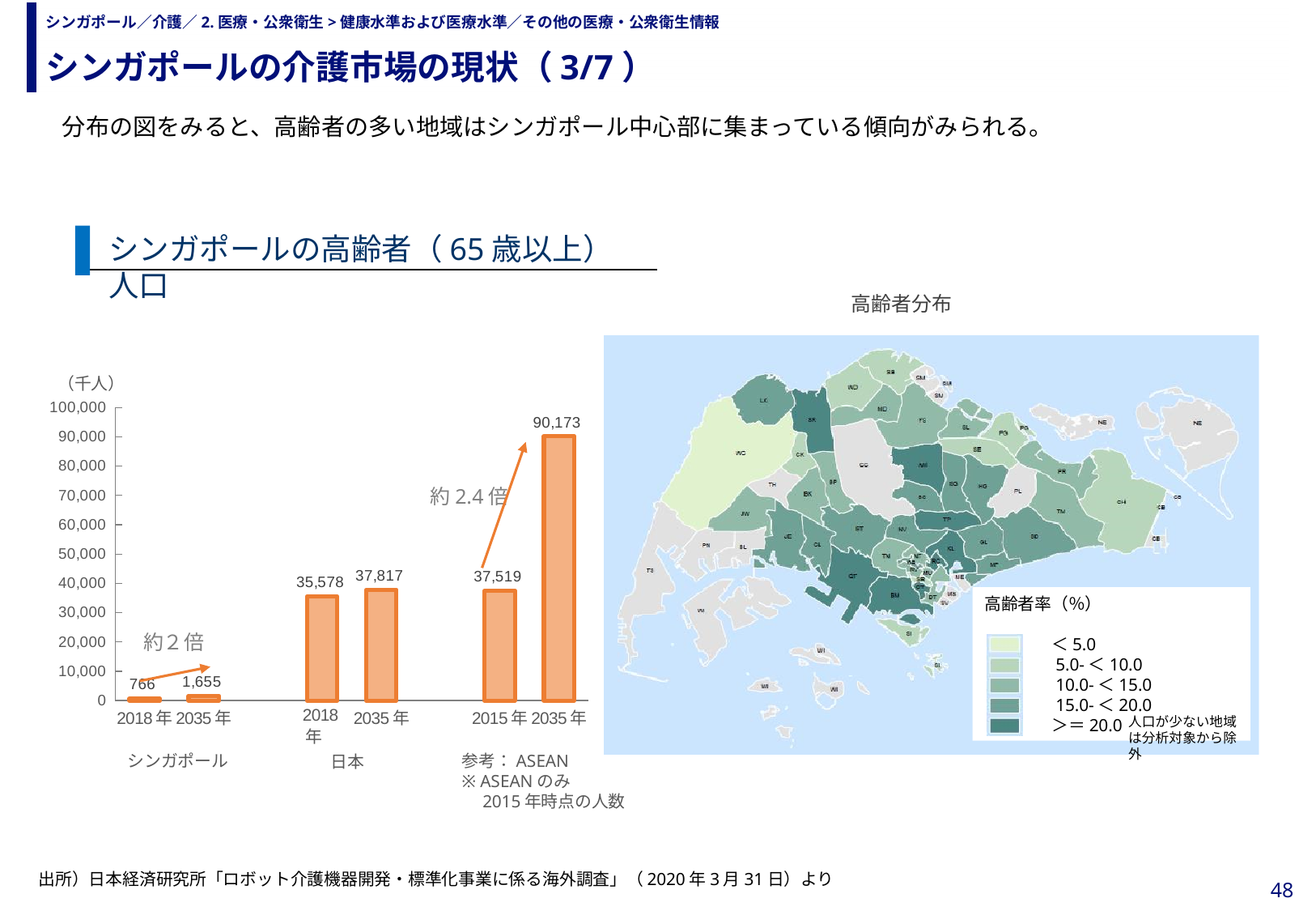
In the bar chart of elderly (65+) population, what is the value for Japan in 2035? 37,817 In the bar chart of elderly (65+) population, is the value for ASEAN in 2035 greater or less than 80,000? greater In the bar chart of elderly (65+) population, what is the difference between Japan's 2035 and 2018 values? 2,239 In the bar chart of elderly (65+) population, what is the value for ASEAN in 2015? 37,519 How many bars are plotted in the bar chart of elderly (65+) population? 6 What unit is shown on the vertical axis of the bar chart of elderly (65+) population? 千人 In the bar chart of elderly (65+) population, which is larger: Japan 2018 or ASEAN 2015? ASEAN 2015 (37,519) In the bar chart of elderly (65+) population, what is the value for Singapore in 2035? 1,655 In the bar chart of elderly (65+) population, which bar has the highest value? ASEAN 2035年 (90,173) In the bar chart of elderly (65+) population, which bar has the lowest value? シンガポール 2018年 (766) What type of chart is used to show the elderly (65+) population on the left of the slide? bar chart In the bar chart of elderly (65+) population, what is the value for Singapore in 2018? 766